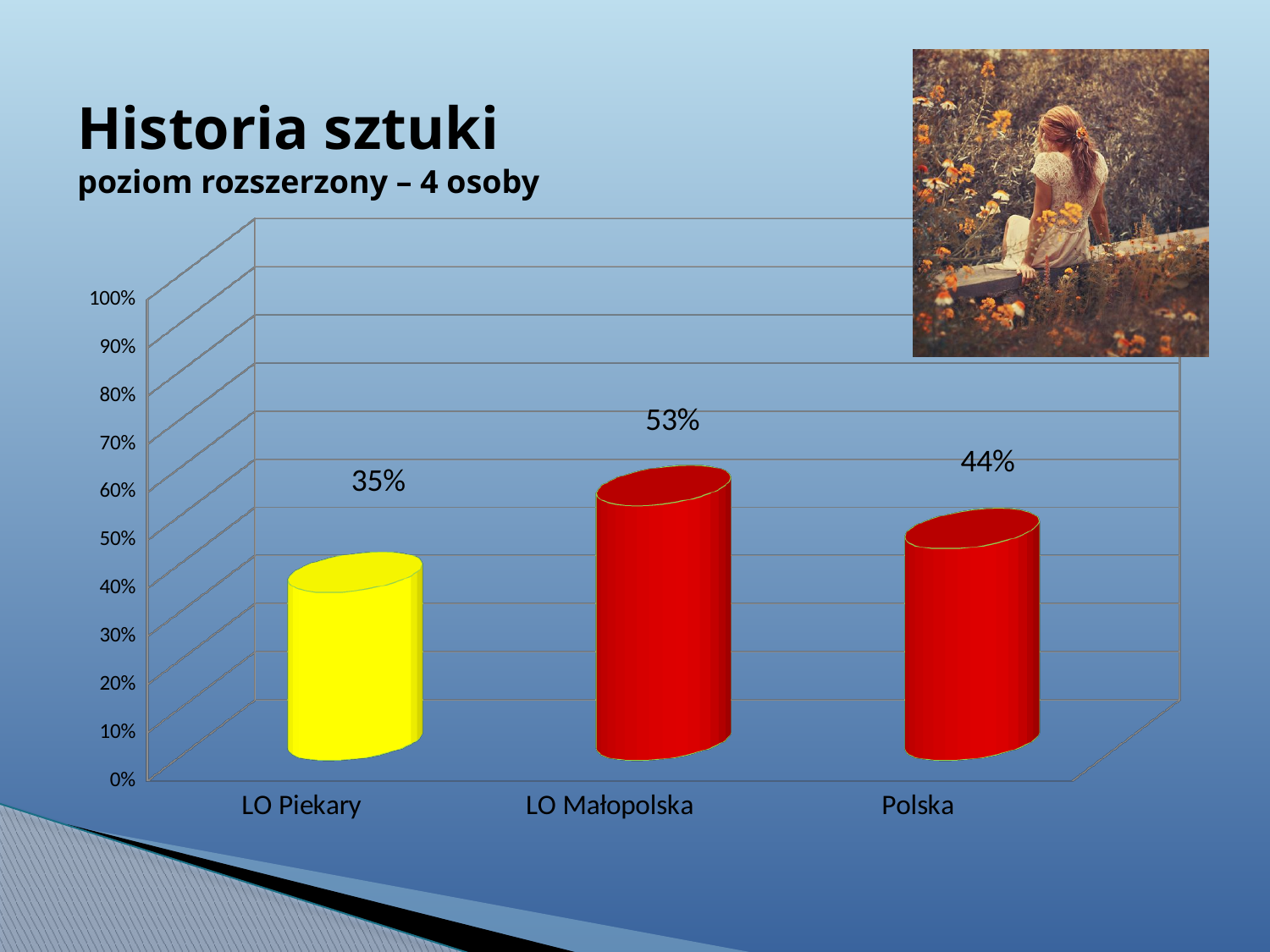
What is the difference between the values for Polska and LO Piekary? 9% What kind of chart is shown on the slide? bar chart How many categories are shown on the x axis? 3 What is the value for LO Piekary? 35% What is the difference between the values for LO Małopolska and LO Piekary? 18% What is the value for Polska? 44% Is the value for LO Małopolska greater or less than 50%? greater What colour is the bar for LO Piekary? yellow Which category has the highest value? LO Małopolska Which category has the lowest value? LO Piekary Which is larger, the value for Polska or the value for LO Piekary? Polska What is the value for LO Małopolska? 53%